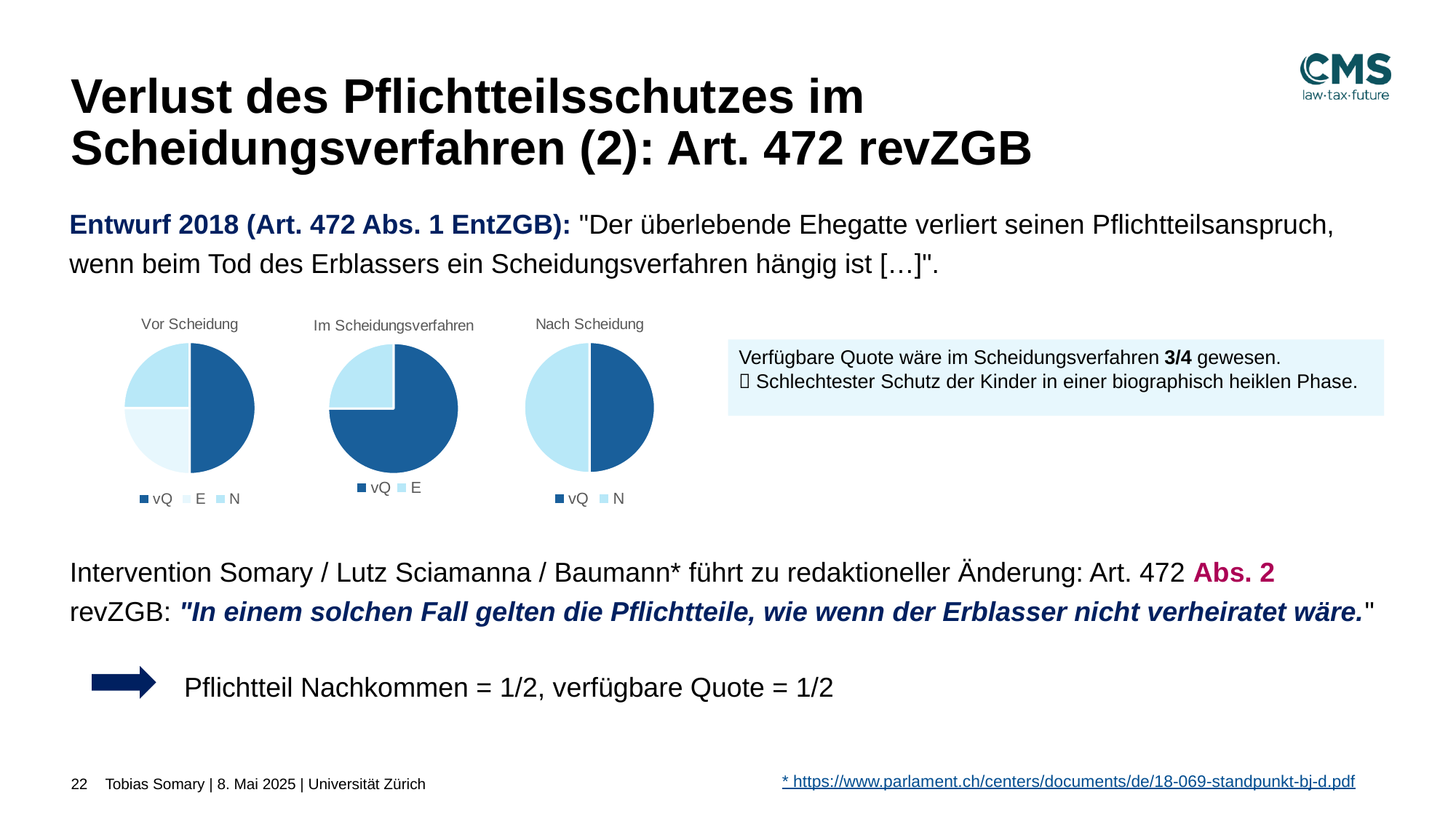
What kind of chart is the "Vor Scheidung" chart? pie chart In the "Im Scheidungsverfahren" pie chart, which slice is larger, vQ or E? vQ How many slices does the "Vor Scheidung" pie chart have? 3 In the "Vor Scheidung" pie chart, which slice is larger, vQ or E? vQ How many pie charts are shown on the slide? 3 In the "Im Scheidungsverfahren" pie chart, which slice is the smallest? E What are the legend entries of the "Vor Scheidung" pie chart? vQ, E, N In the "Im Scheidungsverfahren" pie chart, which slice is the largest? vQ How many slices does the "Im Scheidungsverfahren" pie chart have? 2 What is the title of the middle pie chart? Im Scheidungsverfahren How many entries does the legend of the "Nach Scheidung" chart list? 2 In the "Vor Scheidung" pie chart, which slice is the largest? vQ